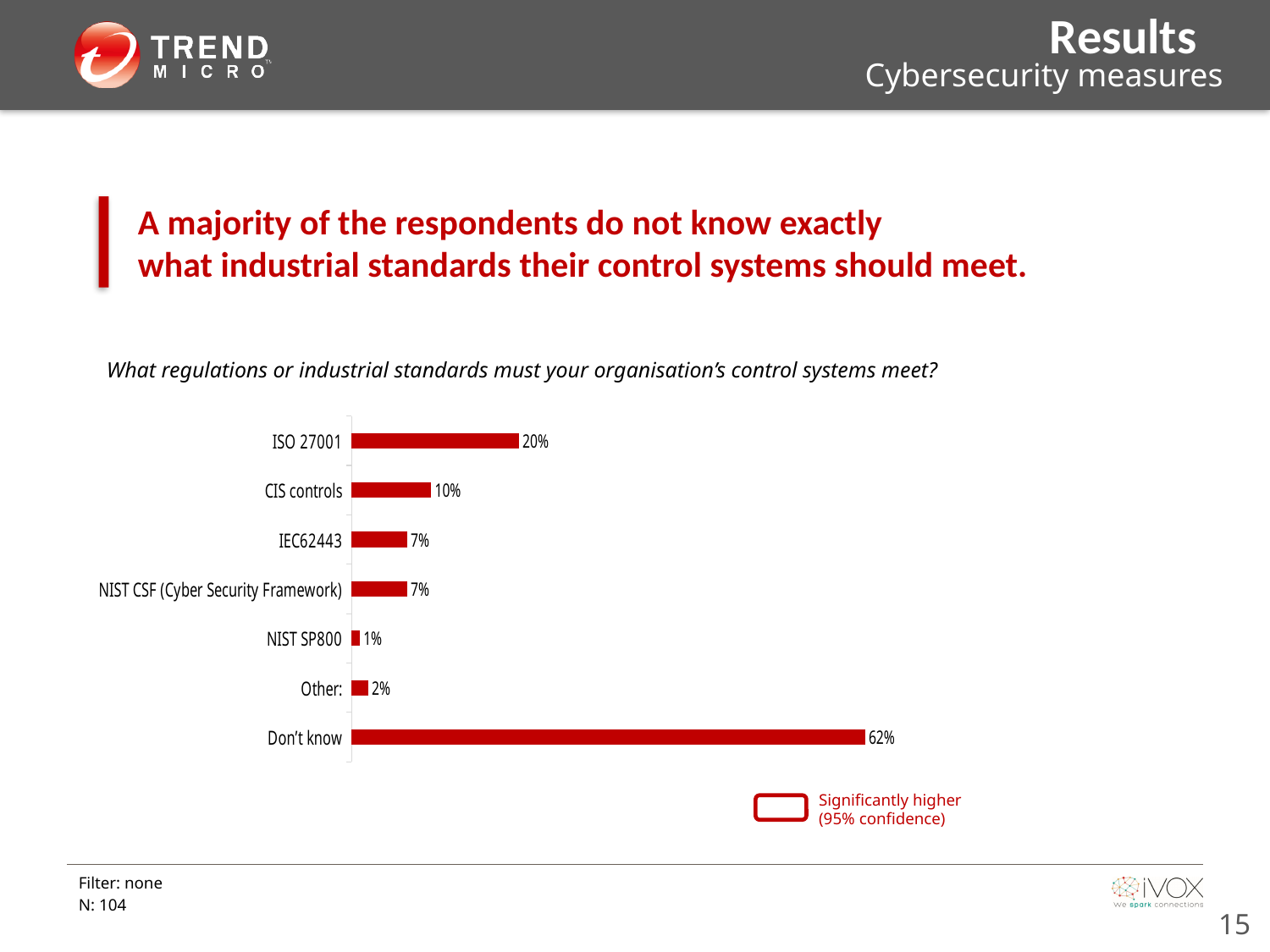
How many categories are shown in the chart? 7 What is the difference in percentage points between 'Don't know' and ISO 27001? 42 What is the value shown for NIST CSF (Cyber Security Framework)? 7% What is the value shown for CIS controls? 10% Which category has the highest value in the chart? Don't know What is the value shown for NIST SP800? 1% Which category has the lowest value in the chart? NIST SP800 What kind of chart is shown on the slide? Bar chart What percentage of respondents said their control systems must meet ISO 27001? 20% What is the difference in percentage points between ISO 27001 and CIS controls? 10 What percentage of respondents answered 'Don't know'? 62% Which is larger, the value for CIS controls or the value for IEC62443? CIS controls